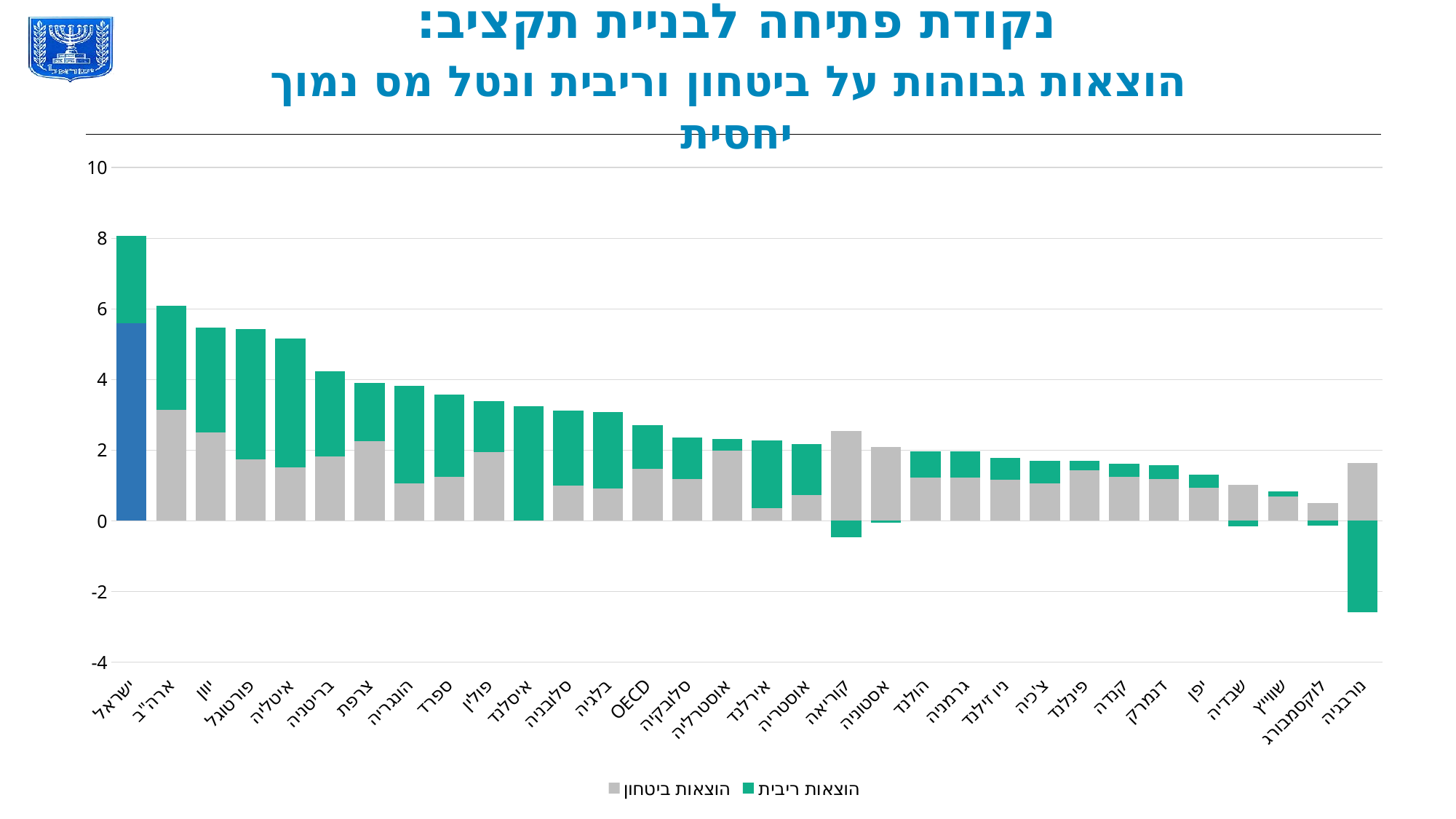
Is the total bar for יוון greater or less than 4? greater Which category has the highest total bar? ישראל Is the gray (הוצאות ביטחון) value for קוריאה greater or less than 2? greater How many series does the legend list? 2 Which has a larger total bar, ישראל or ארה"ב? ישראל Is the green (הוצאות ריבית) value for נורבגיה greater or less than -2? less Which category has the lowest (most negative) value? נורבגיה Do the total bar heights generally rise or fall from left to right along the x axis? fall Which series is shown in green in the legend? הוצאות ריבית How many countries/categories are shown on the x axis? 32 What kind of chart is shown on the slide? Stacked bar chart